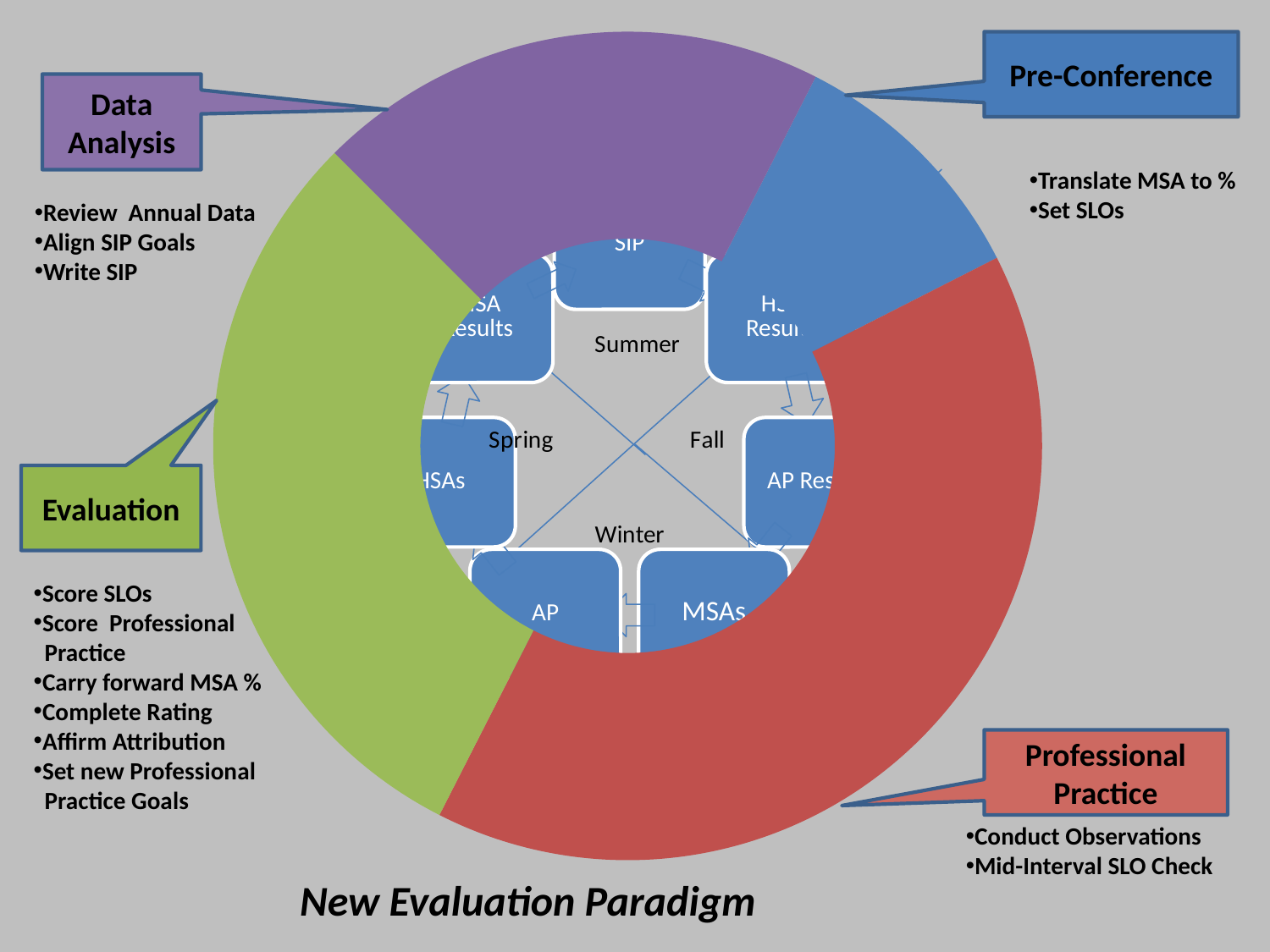
How many segments does the ring chart have? 4 Which segment of the ring chart is the largest? Professional Practice What is the title shown below the chart? New Evaluation Paradigm Which segment is larger, Evaluation or Pre-Conference? Evaluation Which segment of the ring chart is the smallest? Pre-Conference Which segment is larger, Professional Practice or Evaluation? Professional Practice What kind of chart is shown on the slide? Doughnut chart What colour is the Evaluation segment of the ring chart? Green Which segment is larger, Data Analysis or Pre-Conference? Data Analysis